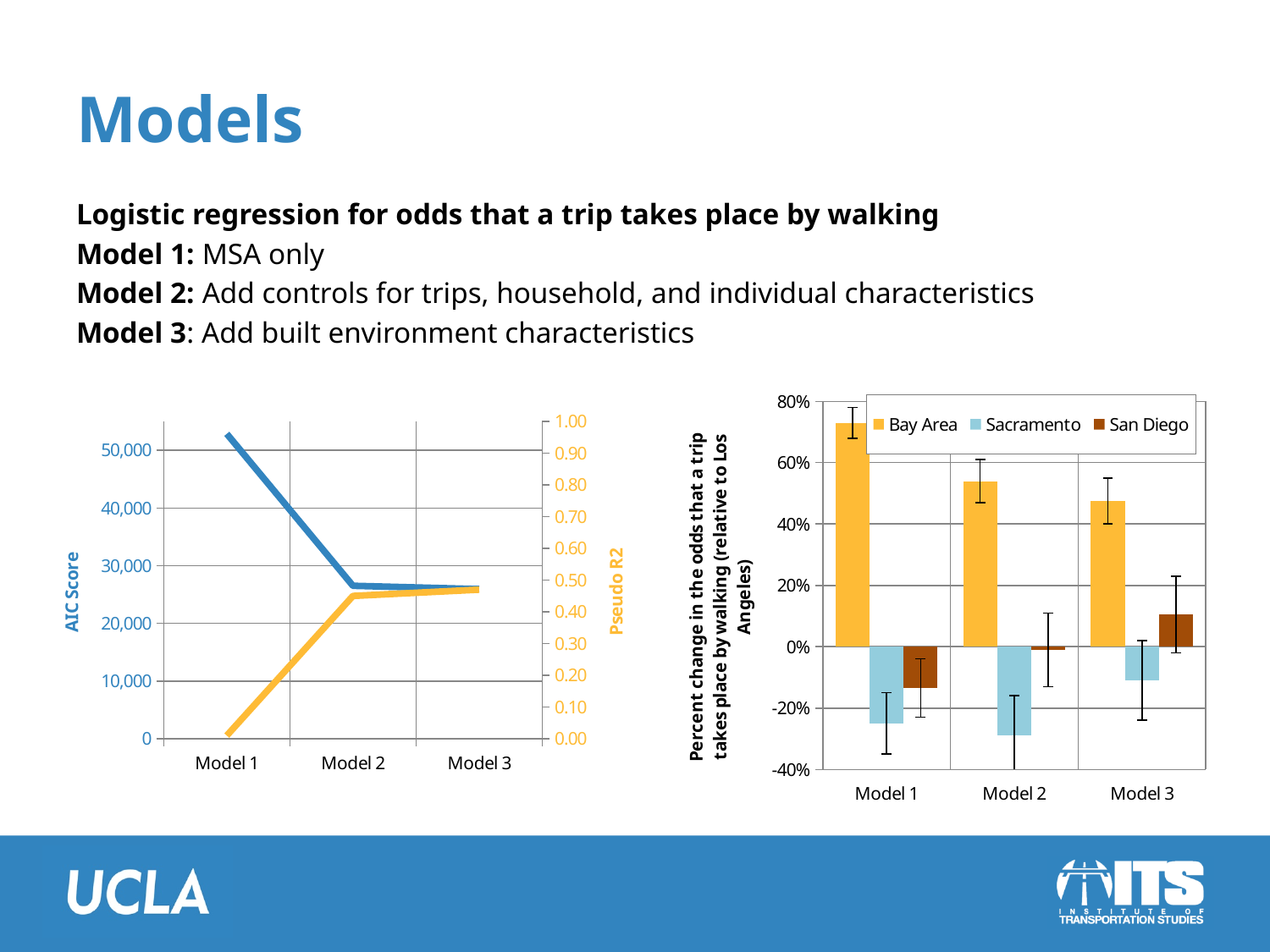
In the left chart, is the Pseudo R2 for Model 1 greater or less than 0.10? less In the left chart, is the AIC Score for Model 1 greater or less than 50,000? greater What kind of chart is the right chart showing percent change in the odds of walking? bar chart In the left chart, does the AIC Score rise or fall from Model 1 to Model 3? fall In the right chart, how many series does the legend list? 3 In the right chart, which model has the highest Bay Area value? Model 1 In the right chart, is the Bay Area value for Model 1 greater or less than 60%? greater In the right chart, how many models are shown on the x axis? 3 In the left chart, does the Pseudo R2 rise or fall from Model 1 to Model 3? rise What kind of chart is the left chart showing AIC Score and Pseudo R2? line chart In the right chart, which series has the highest value for Model 3? Bay Area